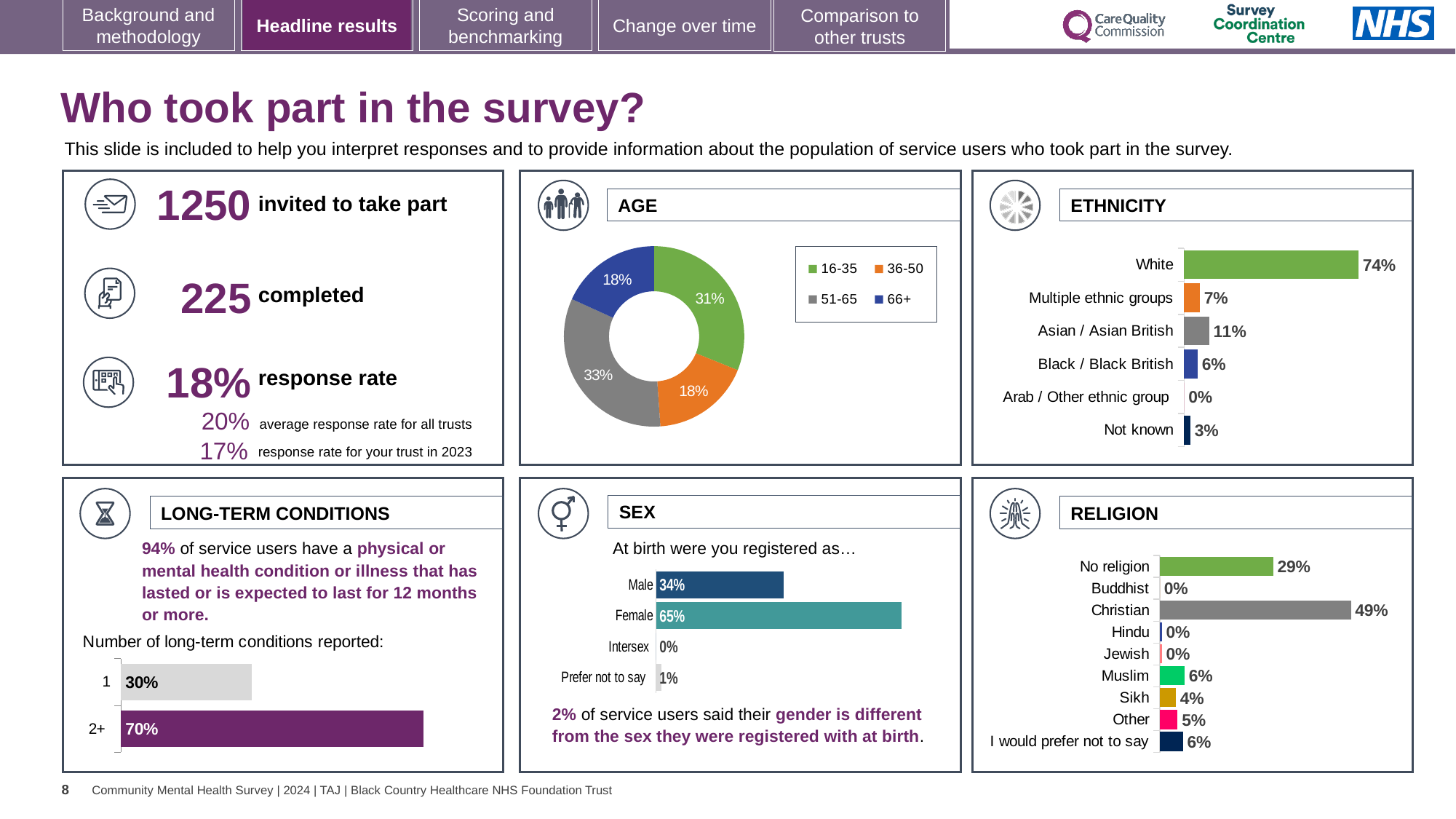
What kind of chart is the AGE chart? Donut (pie) chart In the SEX chart, which is larger, Male or Female? Female In the RELIGION chart, what is the value for Christian? 49% In the ETHNICITY chart, which category has the lowest value? Arab / Other ethnic group How many categories are shown in the ETHNICITY chart? 6 How many categories are shown in the RELIGION chart? 9 In the ETHNICITY chart, what is the difference between White and Multiple ethnic groups? 67% In the ETHNICITY chart, what is the value for Asian / Asian British? 11% In the AGE chart, what share of respondents were aged 51-65? 33% In the LONG-TERM CONDITIONS chart, what percentage reported 2+ conditions? 70% In the AGE chart, which age group has the largest share? 51-65 How many entries does the legend of the AGE chart list? 4